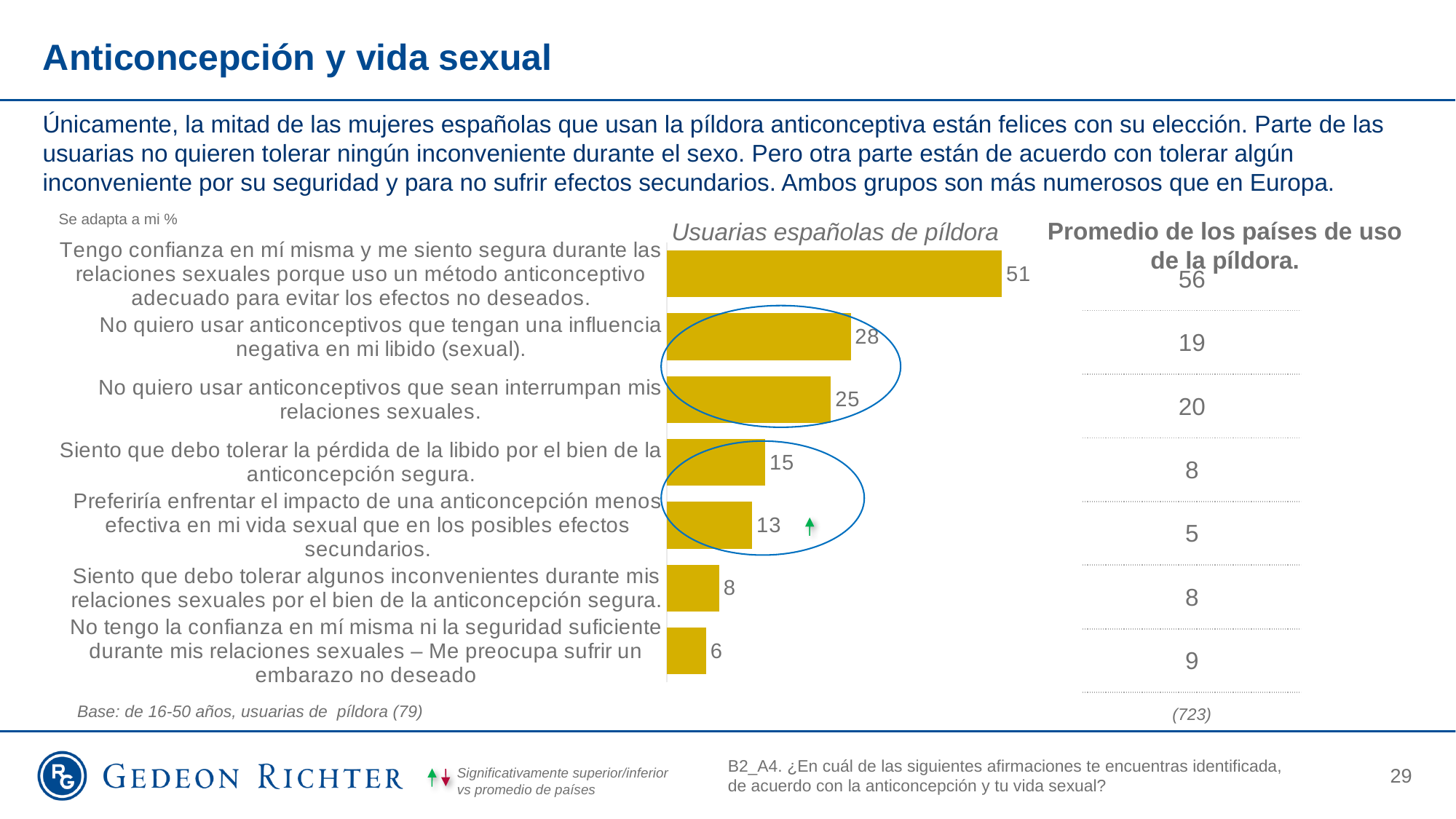
What is the base (sample size) of Spanish pill users shown below the chart? 79 Which is larger: the value for 'Siento que debo tolerar la pérdida de la libido por el bien de la anticoncepción segura' or 'Siento que debo tolerar algunos inconvenientes durante mis relaciones sexuales por el bien de la anticoncepción segura'? Siento que debo tolerar la pérdida de la libido por el bien de la anticoncepción segura. Do the bar values rise or fall from the top statement to the bottom statement? Fall Which statement has the highest value in the bar chart? Tengo confianza en mí misma y me siento segura durante las relaciones sexuales porque uso un método anticonceptivo adecuado para evitar los efectos no deseados. What is the value for 'Preferiría enfrentar el impacto de una anticoncepción menos efectiva en mi vida sexual que en los posibles efectos secundarios'? 13 What is the value for 'Tengo confianza en mí misma y me siento segura durante las relaciones sexuales porque uso un método anticonceptivo adecuado para evitar los efectos no deseados'? 51 What is the value for 'No quiero usar anticonceptivos que tengan una influencia negativa en mi libido (sexual)'? 28 What is the title shown above the bars in the chart? Usuarias españolas de píldora What type of chart is shown on the slide? Bar chart What is the difference between the value for 'No quiero usar anticonceptivos que tengan una influencia negativa en mi libido (sexual)' and 'No quiero usar anticonceptivos que sean interrumpan mis relaciones sexuales'? 3 How many statements (categories) are plotted in the bar chart? 7 Which statement has the lowest value in the bar chart? No tengo la confianza en mí misma ni la seguridad suficiente durante mis relaciones sexuales – Me preocupa sufrir un embarazo no deseado